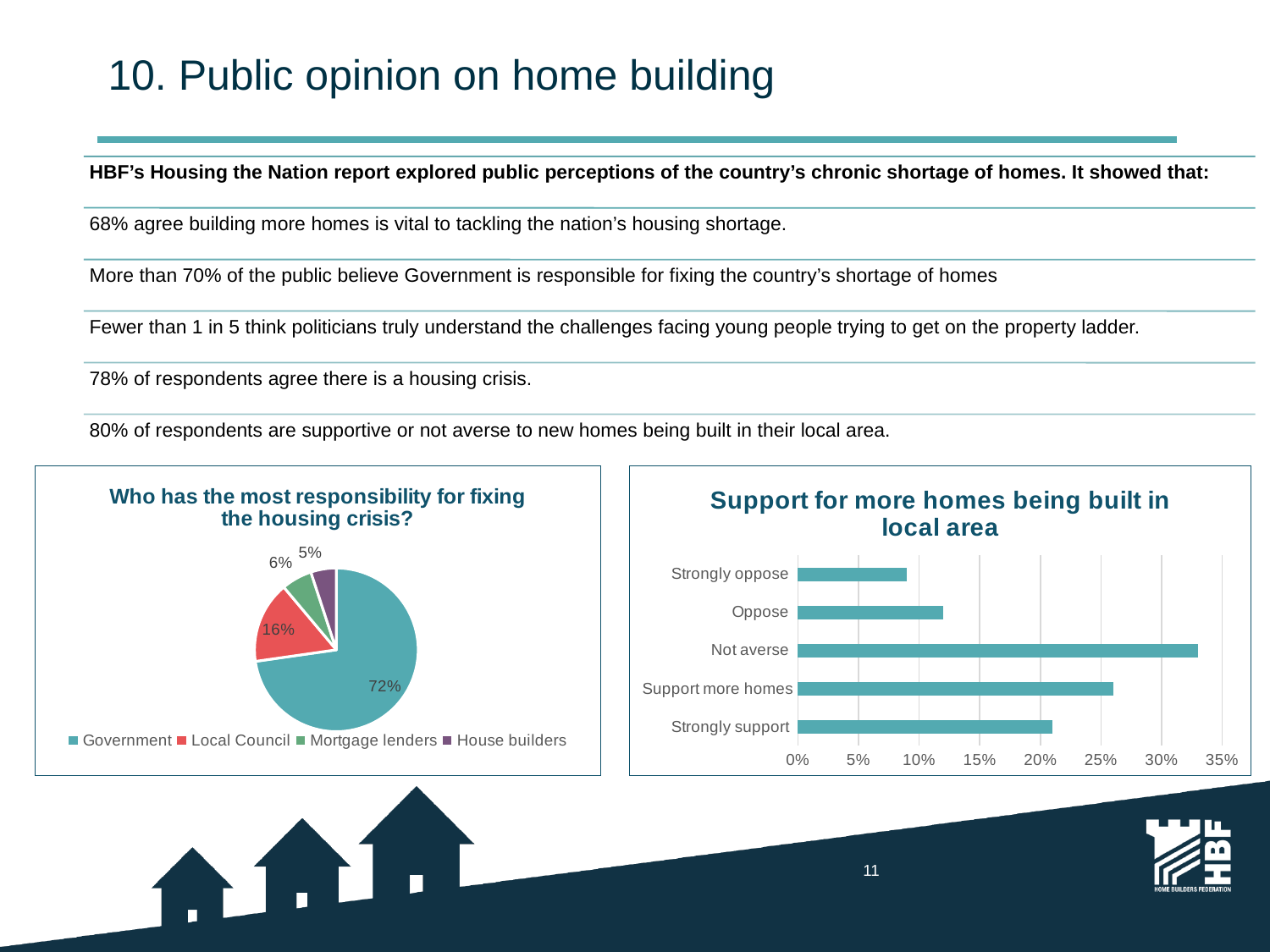
In the pie chart 'Who has the most responsibility for fixing the housing crisis?', what is the difference between the Government share and the Local Council share? 56% In the pie chart 'Who has the most responsibility for fixing the housing crisis?', what share is attributed to Government? 72% In the pie chart 'Who has the most responsibility for fixing the housing crisis?', which category has the smallest slice? House builders In the chart 'Support for more homes being built in local area', which category has the longest bar? Not averse What kind of chart is 'Support for more homes being built in local area'? Bar chart In the chart 'Support for more homes being built in local area', is the value for Strongly oppose greater or less than 10%? less In the pie chart 'Who has the most responsibility for fixing the housing crisis?', what share is attributed to Local Council? 16% In the pie chart 'Who has the most responsibility for fixing the housing crisis?', how many categories does the legend list? 4 In the chart 'Support for more homes being built in local area', is the value for Not averse greater or less than 30%? greater In the chart 'Support for more homes being built in local area', which category has the shortest bar? Strongly oppose In the chart 'Support for more homes being built in local area', how many categories are shown? 5 In the pie chart 'Who has the most responsibility for fixing the housing crisis?', which is larger, Mortgage lenders or House builders? Mortgage lenders